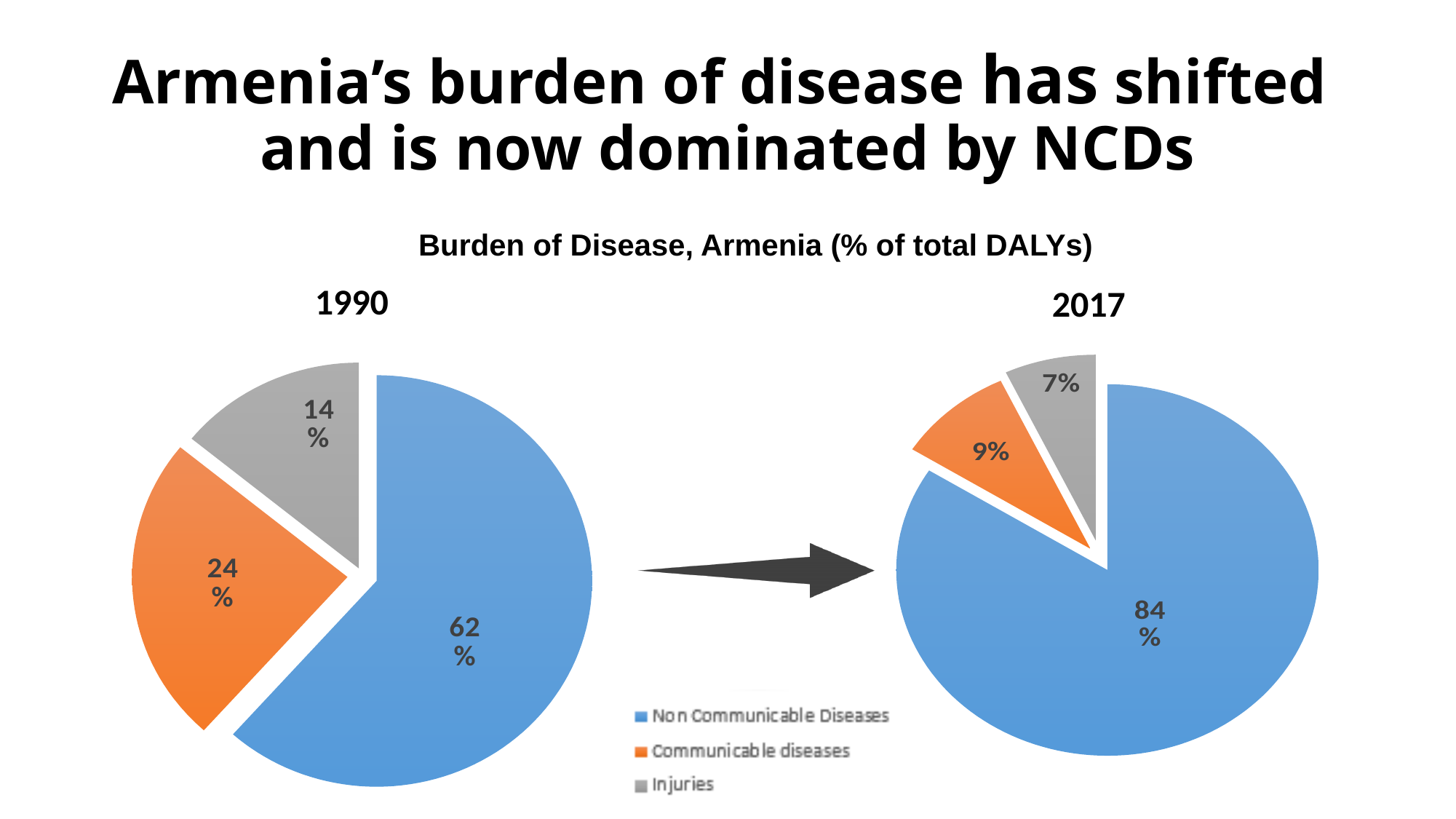
In the 2017 pie chart, which category has the largest share? Non Communicable Diseases What type of chart is used on this slide? Pie chart Which is larger: the Communicable diseases share in the 1990 pie chart or the Communicable diseases share in the 2017 pie chart? 1990 By how many percentage points did the Non Communicable Diseases share increase from the 1990 pie chart to the 2017 pie chart? 22 In the 2017 pie chart, what is the value for Non Communicable Diseases? 84% In the 1990 pie chart, what is the difference between the Communicable diseases share and the Injuries share? 10 In the 2017 pie chart, what share of total DALYs is attributed to Communicable diseases? 9% What is the title shown above the two pie charts? Burden of Disease, Armenia (% of total DALYs) In the 1990 pie chart, what share of total DALYs is attributed to Non Communicable Diseases? 62% In the 1990 pie chart, what is the value for Injuries? 14% In the 1990 pie chart, which category has the smallest share? Injuries How many categories does each pie chart show? 3